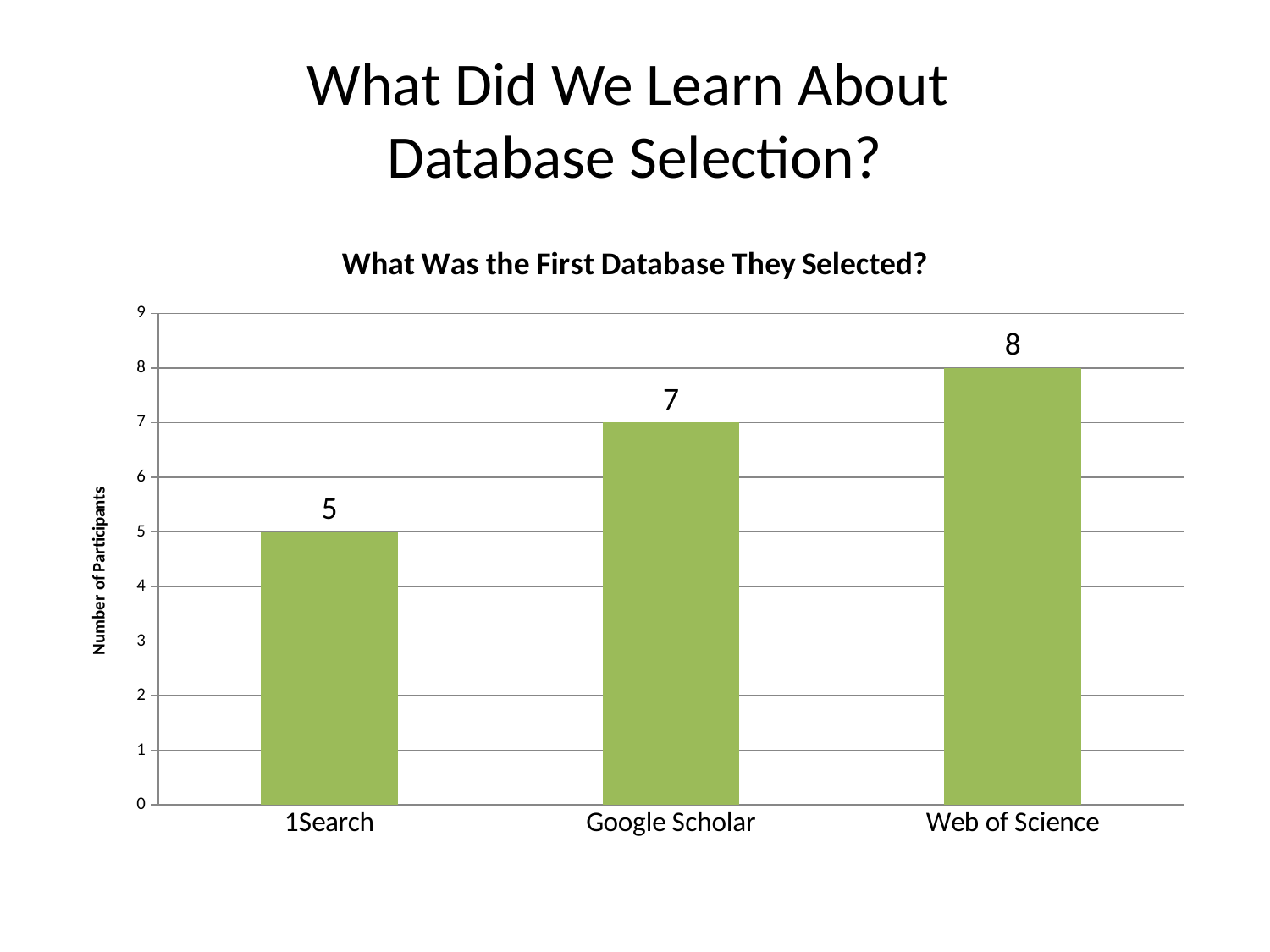
How many participants selected 1Search as their first database? 5 What is the value for Web of Science? 8 Which database has the lowest number of participants? 1Search What kind of chart is shown on the slide? bar chart What is the difference between the values for Web of Science and 1Search? 3 What is the difference between the values for Google Scholar and 1Search? 2 Which is larger, the value for Google Scholar or the value for 1Search? Google Scholar What is the title of the chart? What Was the First Database They Selected? Is the value for 1Search greater or less than 6? less How many databases are shown on the chart? 3 Which database has the highest number of participants? Web of Science What is the value for Google Scholar? 7